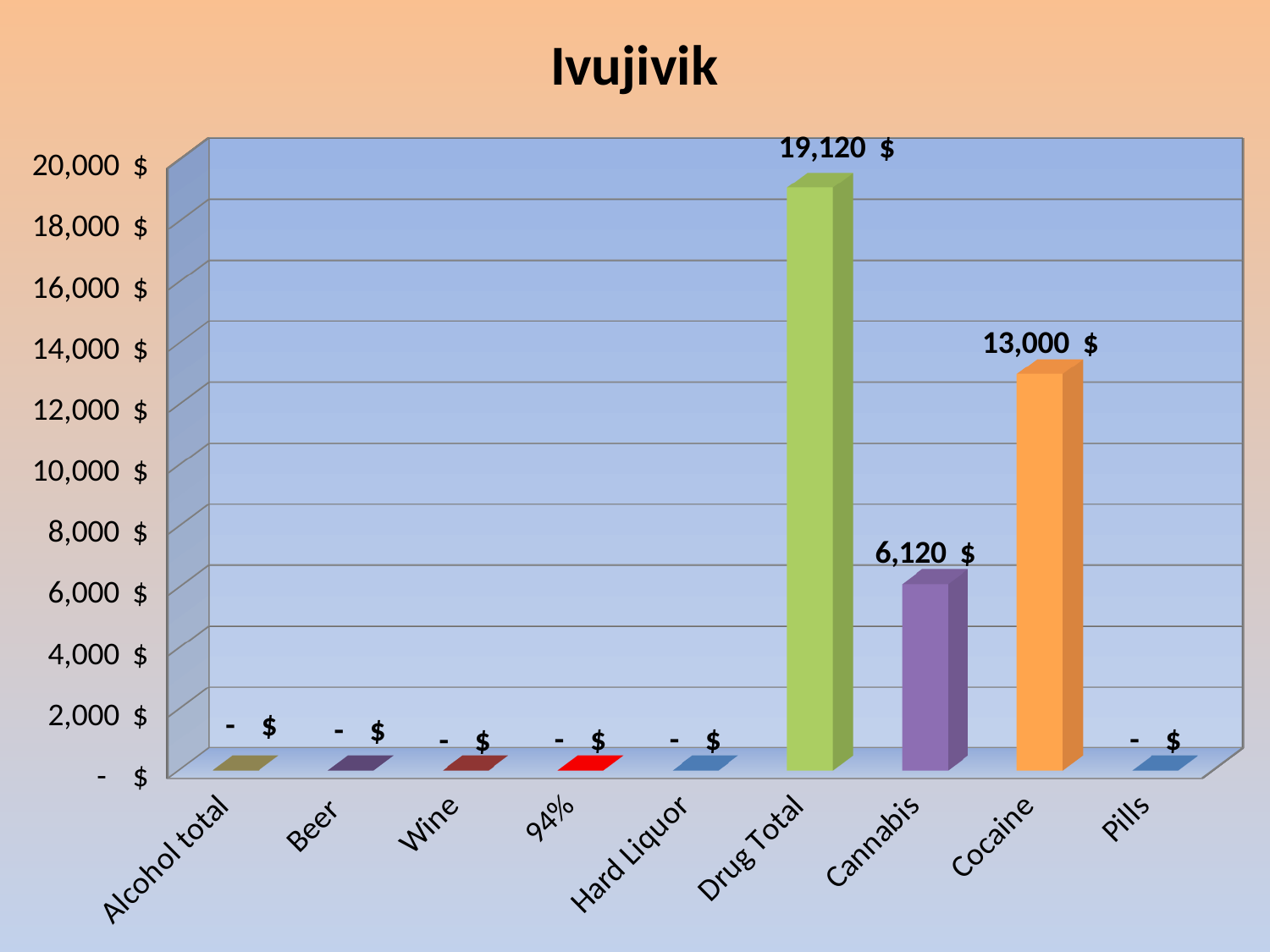
What is the data label shown for Beer? - $ What is the value for Cocaine? 13,000 $ Which is larger, the value for Cocaine or the value for Cannabis? Cocaine What is the value for Cannabis? 6,120 $ What kind of chart is shown on the slide? bar chart Is the value for Cannabis greater or less than 8,000 $? less What is the difference between the values for Cocaine and Cannabis? 6,880 $ What is the title of the chart? Ivujivik How many categories are shown on the x axis? 9 What is the value for Drug Total? 19,120 $ Which category has the highest value? Drug Total What is the difference between the values for Drug Total and Cocaine? 6,120 $